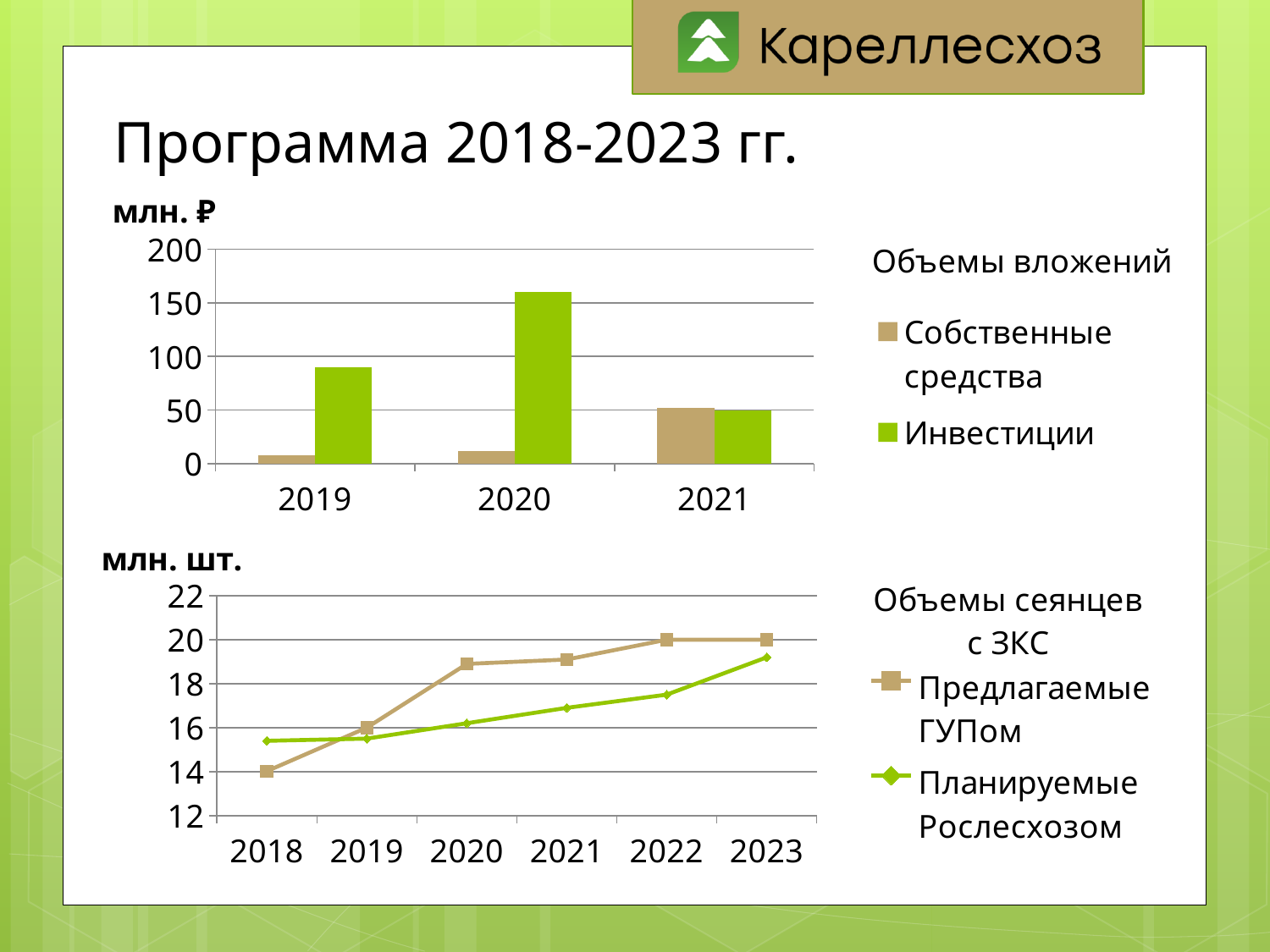
In the top chart "Объемы вложений", which year has the lowest value for Инвестиции? 2021 In the top chart "Объемы вложений", is the value for Инвестиции in 2020 greater or less than 150? greater In the top chart "Объемы вложений", which is larger in 2019: Собственные средства or Инвестиции? Инвестиции In the top chart "Объемы вложений", how many series does the legend list? 2 In the top chart "Объемы вложений", is the value for Собственные средства in 2019 greater or less than 50? less In the top chart "Объемы вложений", which year has the highest value for Инвестиции? 2020 In the bottom chart "Объемы сеянцев с ЗКС", how many years are shown on the x axis? 6 In the bottom chart "Объемы сеянцев с ЗКС", which series is higher in 2018: Предлагаемые ГУПом or Планируемые Рослесхозом? Планируемые Рослесхозом In the bottom chart "Объемы сеянцев с ЗКС", do the values for Планируемые Рослесхозом rise or fall from 2018 to 2023? rise What type of chart is the bottom chart, "Объемы сеянцев с ЗКС"? line chart What type of chart is the top chart, "Объемы вложений"? bar chart